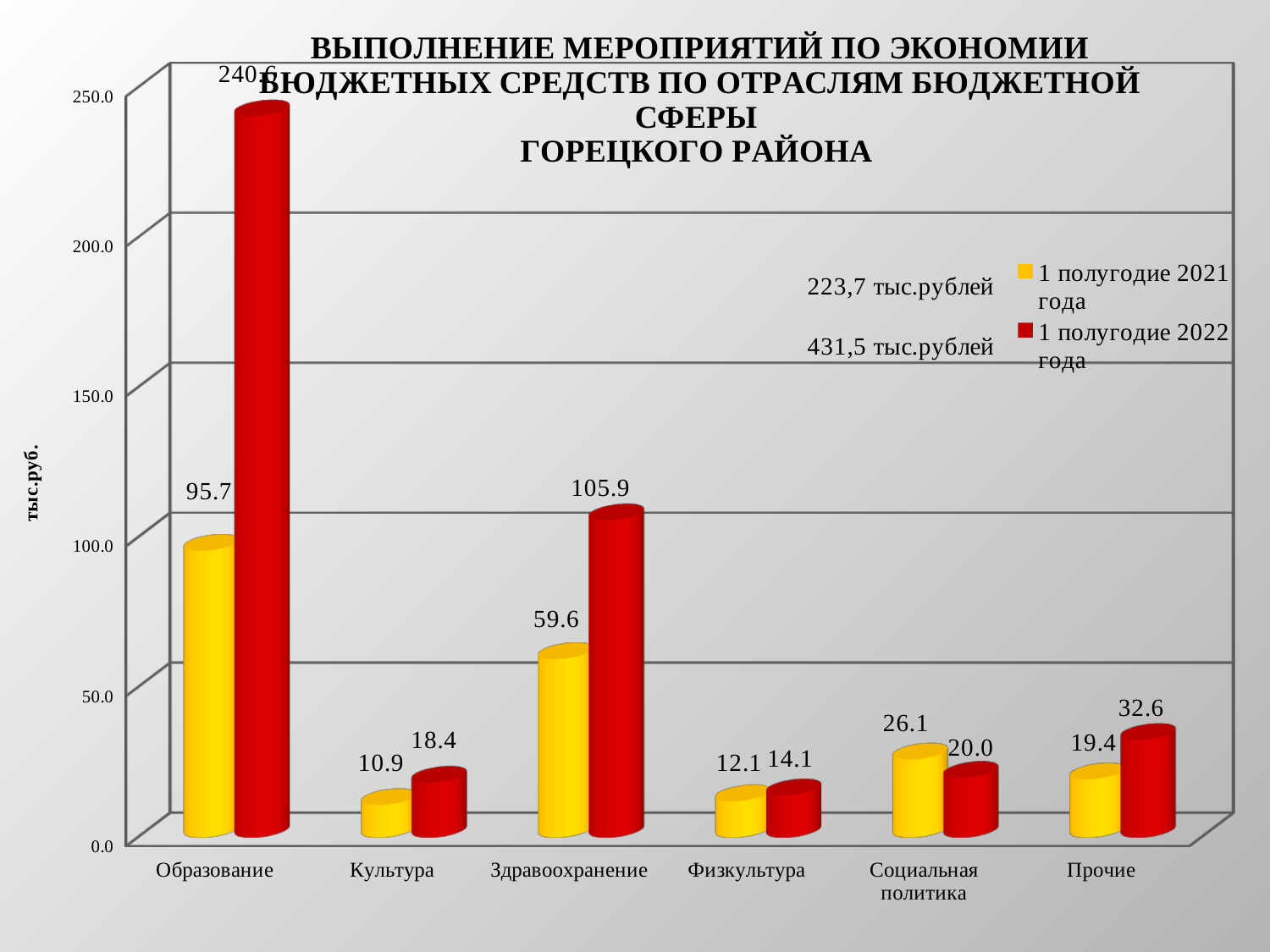
Which category has the highest value in 1 полугодие 2022 года? Образование Is the value for Образование in 1 полугодие 2022 года greater or less than 200? greater What is the difference between the 1 полугодие 2022 года and 1 полугодие 2021 года values for Здравоохранение? 46.3 What is the value for Социальная политика in 1 полугодие 2021 года? 26.1 What is the value for Образование in 1 полугодие 2021 года? 95.7 For Социальная политика, which is larger: the 1 полугодие 2021 года value or the 1 полугодие 2022 года value? 1 полугодие 2021 года How many series does the legend list? 2 What type of chart is shown on the slide? bar chart What is the value for Здравоохранение in 1 полугодие 2022 года? 105.9 Which category has the lowest value in 1 полугодие 2021 года? Культура How many categories are shown on the x axis? 6 What colour are the bars for 1 полугодие 2022 года? red